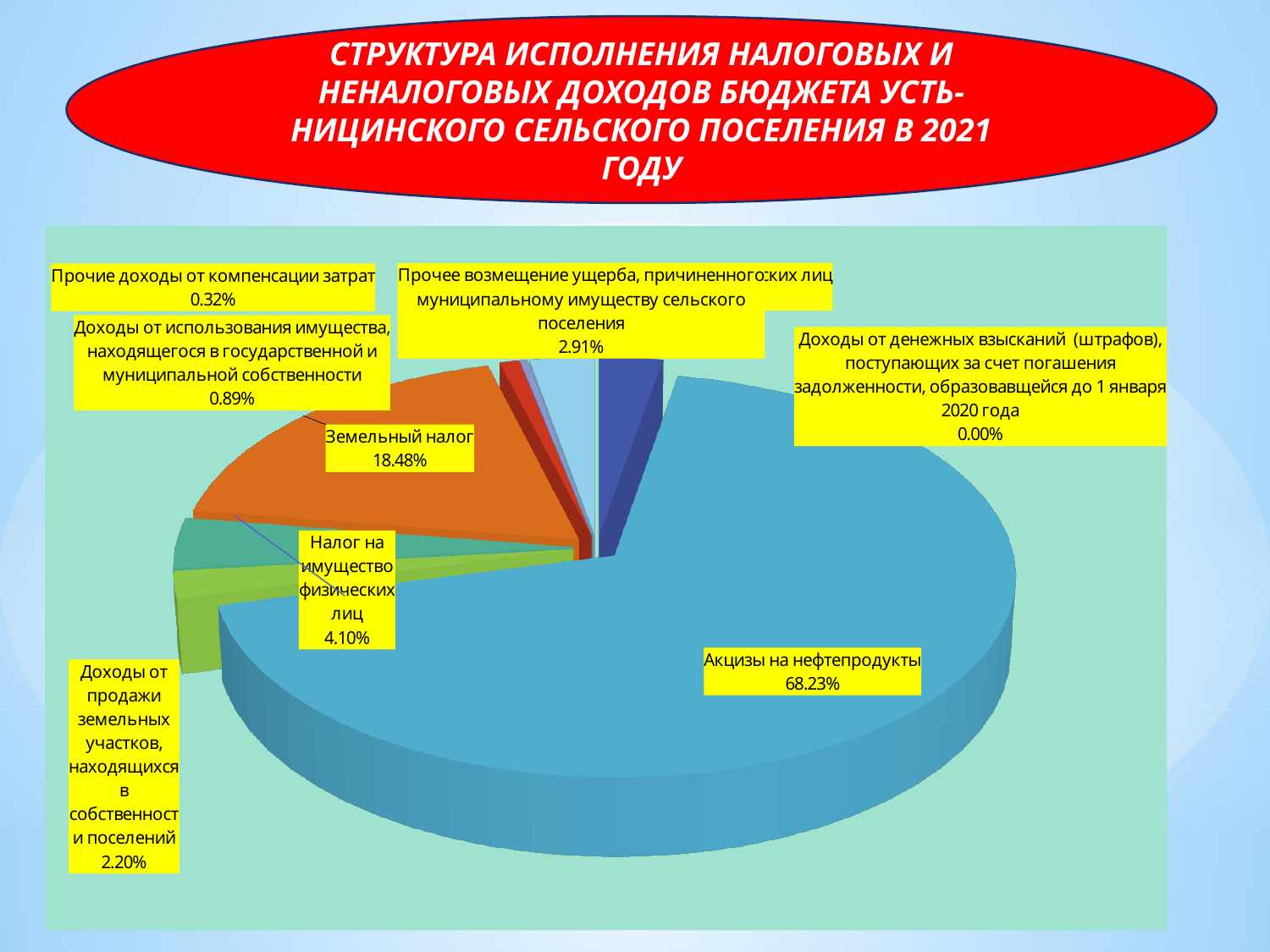
What share does Прочие доходы от компенсации затрат have in the pie chart? 0.32% What share does Земельный налог have in the pie chart? 18.48% Which category has the smallest share in the pie chart? Доходы от денежных взысканий (штрафов), поступающих за счет погашения задолженности, образовавшейся до 1 января 2020 года Which category has the largest share in the pie chart? Акцизы на нефтепродукты Which year does the chart title say the budget revenue structure refers to? 2021 What share does Налог на имущество физических лиц have in the pie chart? 4.10% What kind of chart is shown on the slide? pie chart What share does Доходы от использования имущества, находящегося в государственной и муниципальной собственности have in the pie chart? 0.89% What is the difference in percentage points between the shares of Акцизы на нефтепродукты and Земельный налог? 49.75 Which has the larger share: Налог на имущество физических лиц or Доходы от продажи земельных участков, находящихся в собственности поселений? Налог на имущество физических лиц What share does Доходы от продажи земельных участков, находящихся в собственности поселений have in the pie chart? 2.20% What share does Акцизы на нефтепродукты have in the pie chart? 68.23%